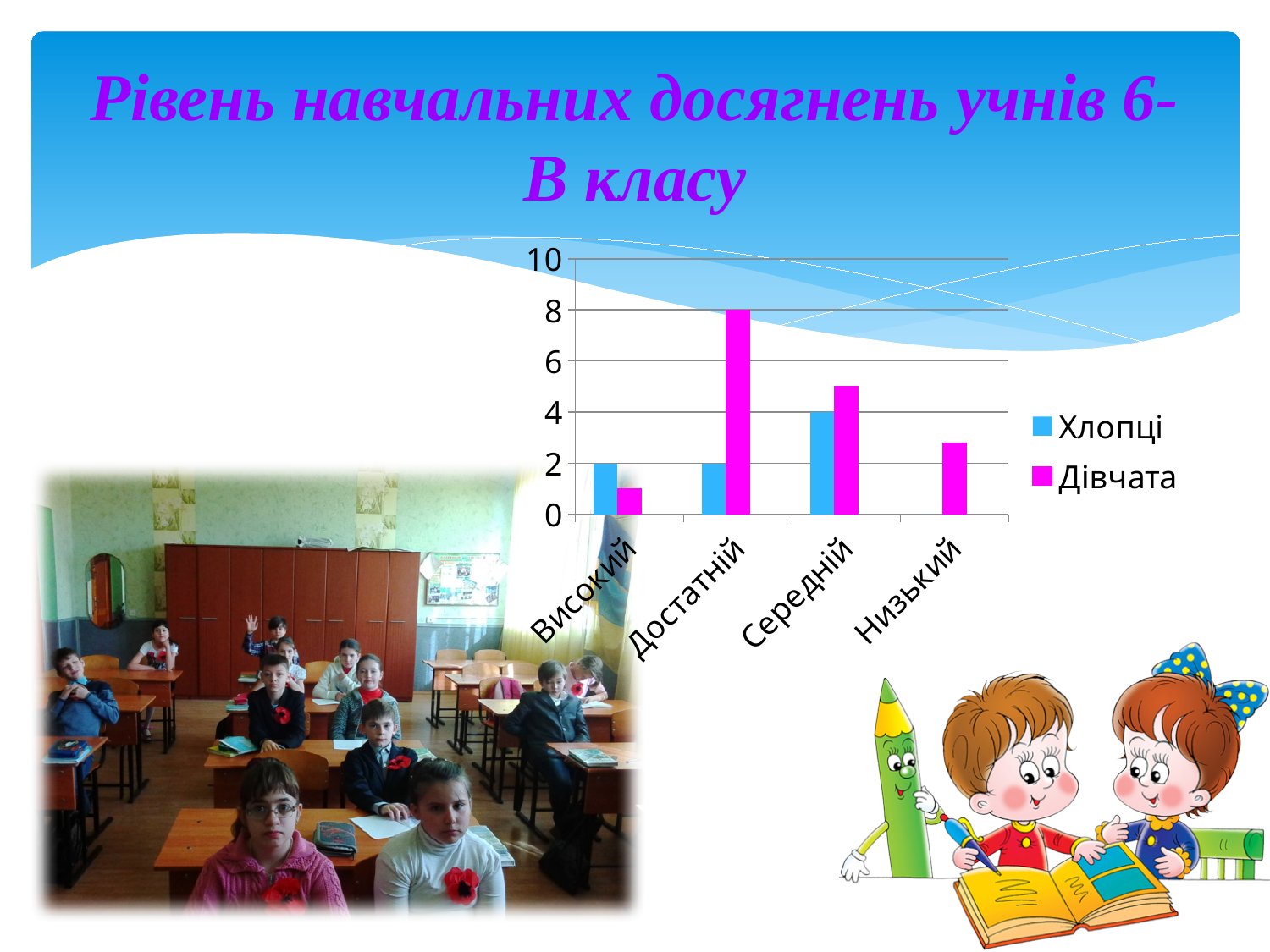
What is the value for Дівчата in the Достатній category? 8 How many series does the chart legend list? 2 Is the value for Дівчата in the Середній category greater or less than 4? greater Which series is shown in magenta in the chart legend? Дівчата What is the value for Хлопці in the Високий category? 2 In which category is the value for Хлопці highest? Середній How many categories are shown on the x axis of the chart? 4 In which category is the value for Дівчата highest? Достатній What kind of chart is shown on the slide? bar chart What is the value for Хлопці in the Середній category? 4 What is the difference between Дівчата and Хлопці in the Достатній category? 6 In the Достатній category, which is larger: Хлопці or Дівчата? Дівчата